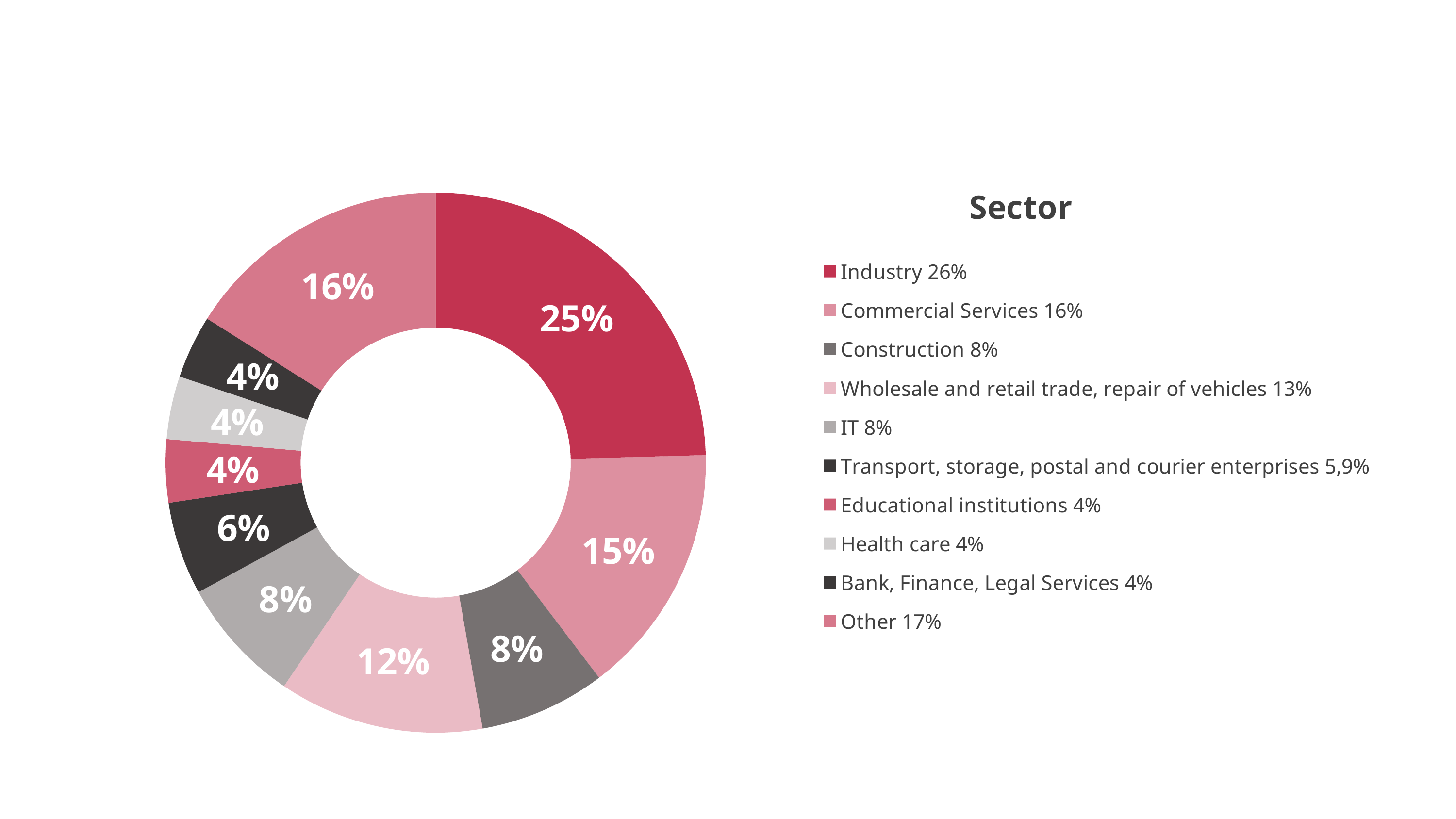
What is the title shown above the legend of the chart? Sector What is the difference in percentage points between Construction (8%) and Educational institutions (4%)? 4 percentage points What data label is printed on the largest slice of the chart? 25% What percentage is shown for Health care? 4% What type of chart is shown on the slide? Doughnut (pie) chart According to the legend, what percentage is listed for Transport, storage, postal and courier enterprises? 5,9% According to the legend, what percentage is listed for Industry? 26% According to the legend, what percentage is listed for Other? 17% How many sectors (categories) does the legend of the chart list? 10 Which is larger, the slice for Industry or the slice for Commercial Services? Industry What percentage is shown for Construction? 8% Which sector has the largest slice in the chart? Industry